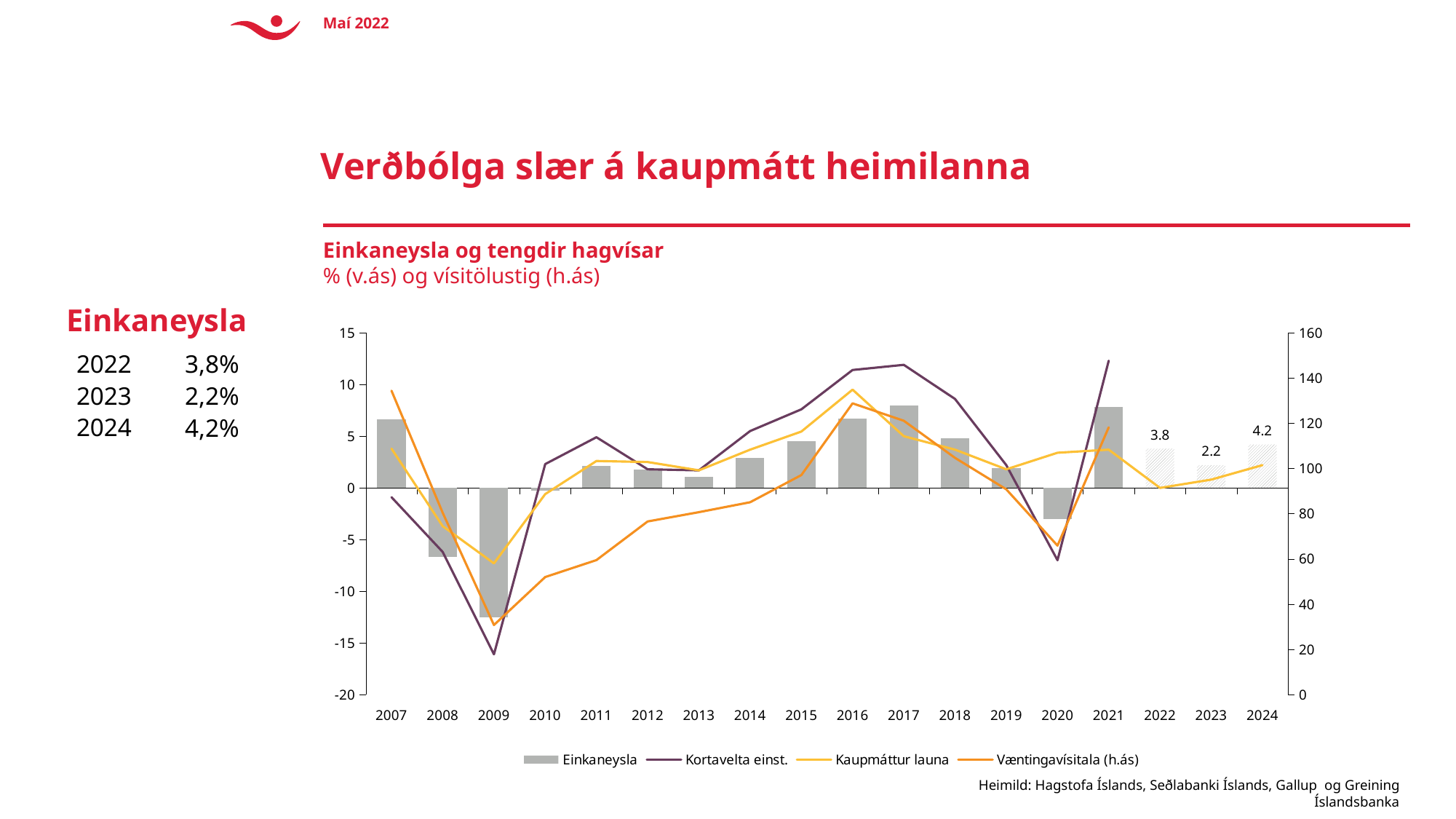
How many years are shown on the x axis of the chart? 18 Which year has the larger Einkaneysla value, 2022 or 2023? 2022 Does the Kortavelta einst. line rise or fall from 2017 to 2020? Fall How many series does the chart legend list? 4 Is the Einkaneysla bar for 2017 greater or less than 5? greater Is the Einkaneysla bar for 2009 greater or less than -10? less Which year has the lowest Einkaneysla bar? 2009 What kind of chart is shown on the slide? Combined bar and line chart What is the Einkaneysla value shown for 2023? 2.2 What is the difference between the Einkaneysla values for 2024 and 2023? 2.0 What is the Einkaneysla value shown for 2022? 3.8 What is the Einkaneysla value shown for 2024? 4.2